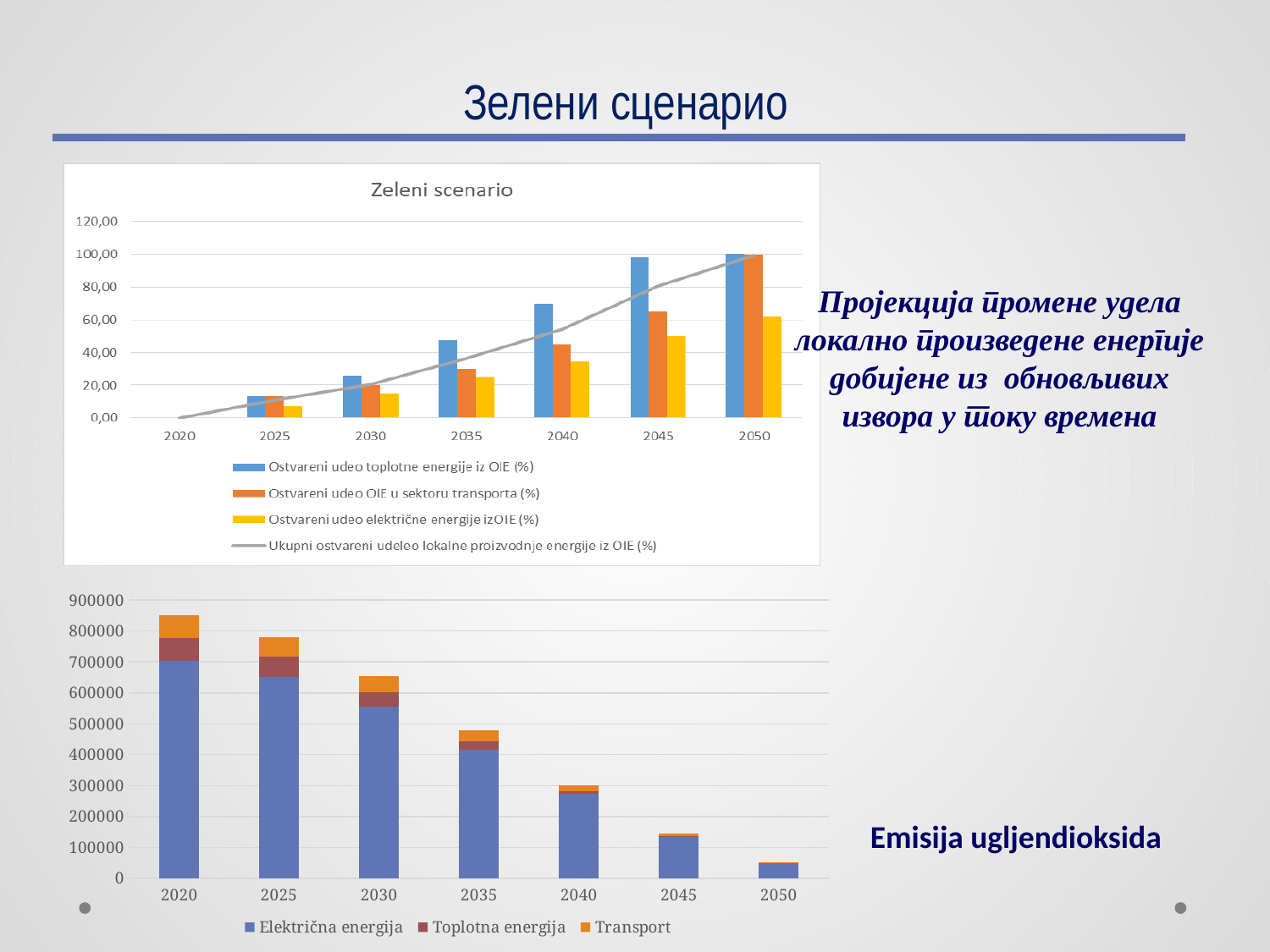
In the 'Zeleni scenario' chart, does the grey line 'Ukupni ostvareni udeleo lokalne proizvodnje energije iz OIE (%)' rise or fall from 2020 to 2050? rise In the bottom chart (Emisija ugljendioksida), which year has the highest total emissions? 2020 What kind of chart is the bottom chart on the slide (the one labelled Emisija ugljendioksida)? stacked bar chart In the bottom chart (Emisija ugljendioksida), is the total for 2050 greater or less than 100000? less In the bottom chart (Emisija ugljendioksida), do the total emissions rise or fall from 2020 to 2050? fall How many series does the legend of the bottom chart (Emisija ugljendioksida) list? 3 How many years are shown on the x axis of the 'Zeleni scenario' chart? 7 How many entries does the legend of the 'Zeleni scenario' chart list? 4 In the 'Zeleni scenario' chart, is the value of 'Ostvareni udeo toplotne energije iz OIE (%)' for 2040 greater or less than 60,00? greater In the bottom chart (Emisija ugljendioksida), which year has the lowest total emissions? 2050 In the 'Zeleni scenario' chart, which is larger for 'Ostvareni udeo električne energije izOIE (%)': 2025 or 2045? 2045 In the bottom chart (Emisija ugljendioksida), is the total for 2020 greater or less than 800000? greater